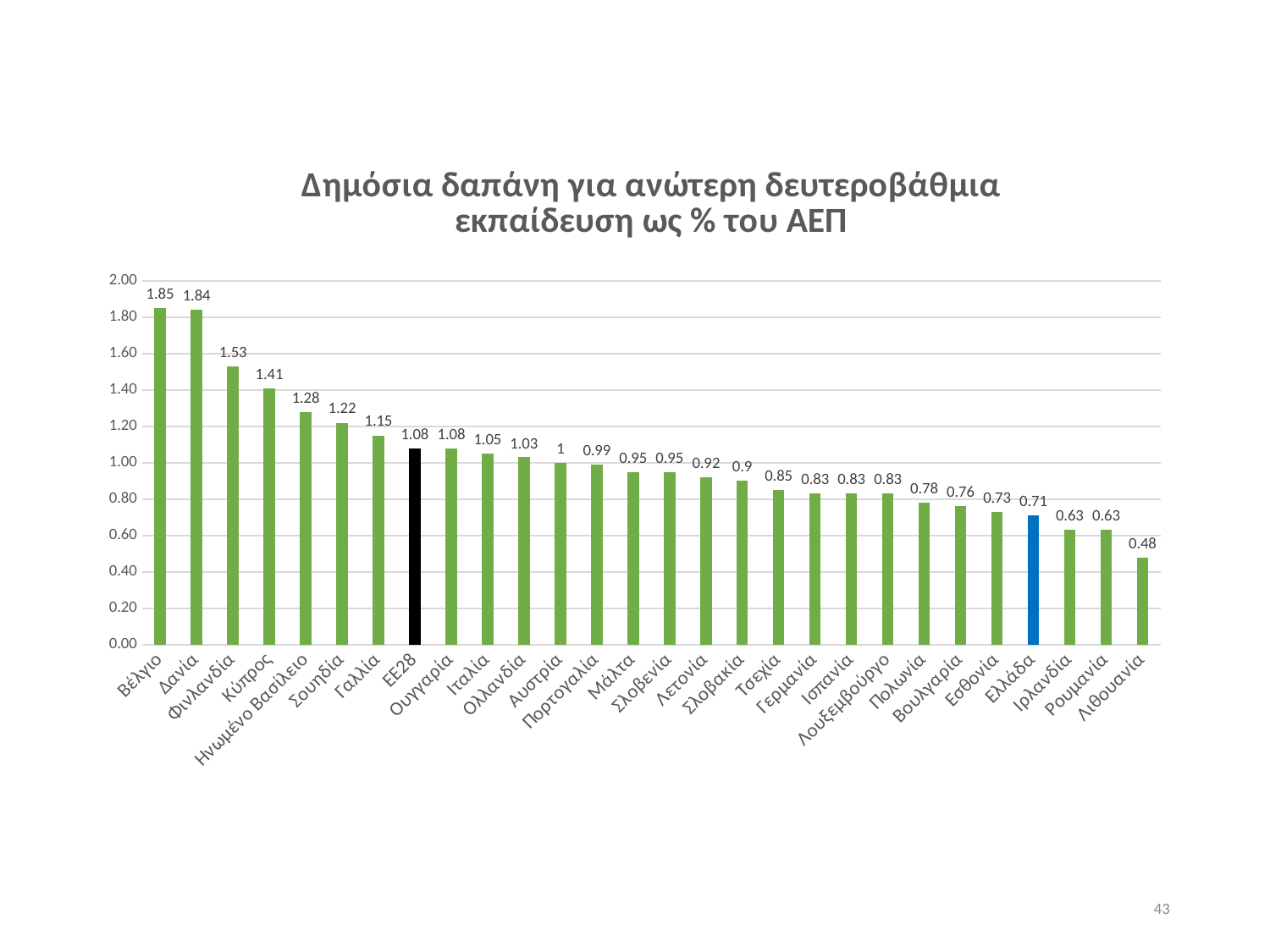
What is the value for Κύπρος? 1.41 Do the values rise or fall from left to right along the x axis? Fall Which category has the highest value? Βέλγιο What is the difference between the values for Βέλγιο and Ελλάδα? 1.14 What colour is the bar for Ελλάδα? Blue Which is larger, the value for Φινλανδία or the value for Σουηδία? Φινλανδία What is the value for Λιθουανία? 0.48 What kind of chart is this? Bar chart What is the value for ΕΕ28? 1.08 What is the value for Ελλάδα? 0.71 Which category has the lowest value? Λιθουανία How many categories are shown on the x axis? 28